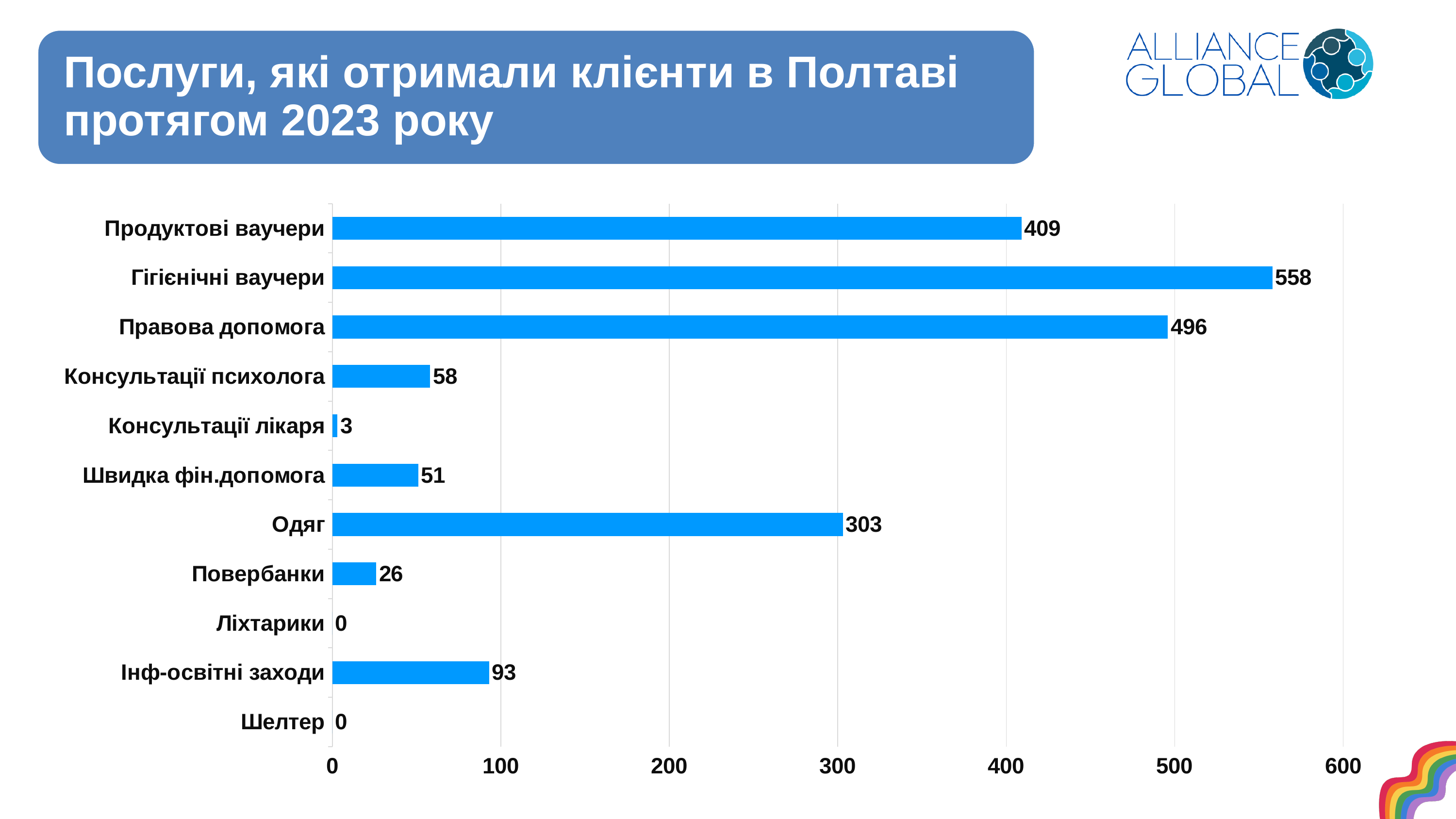
What is the value for Гігієнічні ваучери? 558 What is the difference between Продуктові ваучери and Одяг? 106 What is the difference between Гігієнічні ваучери and Правова допомога? 62 What kind of chart is shown on the slide? bar chart Which is larger, Консультації психолога or Швидка фін.допомога? Консультації психолога Which category has the highest value? Гігієнічні ваучери What is the value for Одяг? 303 How many categories have a value of 0? 2 Which category has the highest non-zero value among those below 100? Інф-освітні заходи Is the value for Правова допомога greater or less than 400? greater How many categories are shown on the chart? 11 What is the value for Консультації лікаря? 3